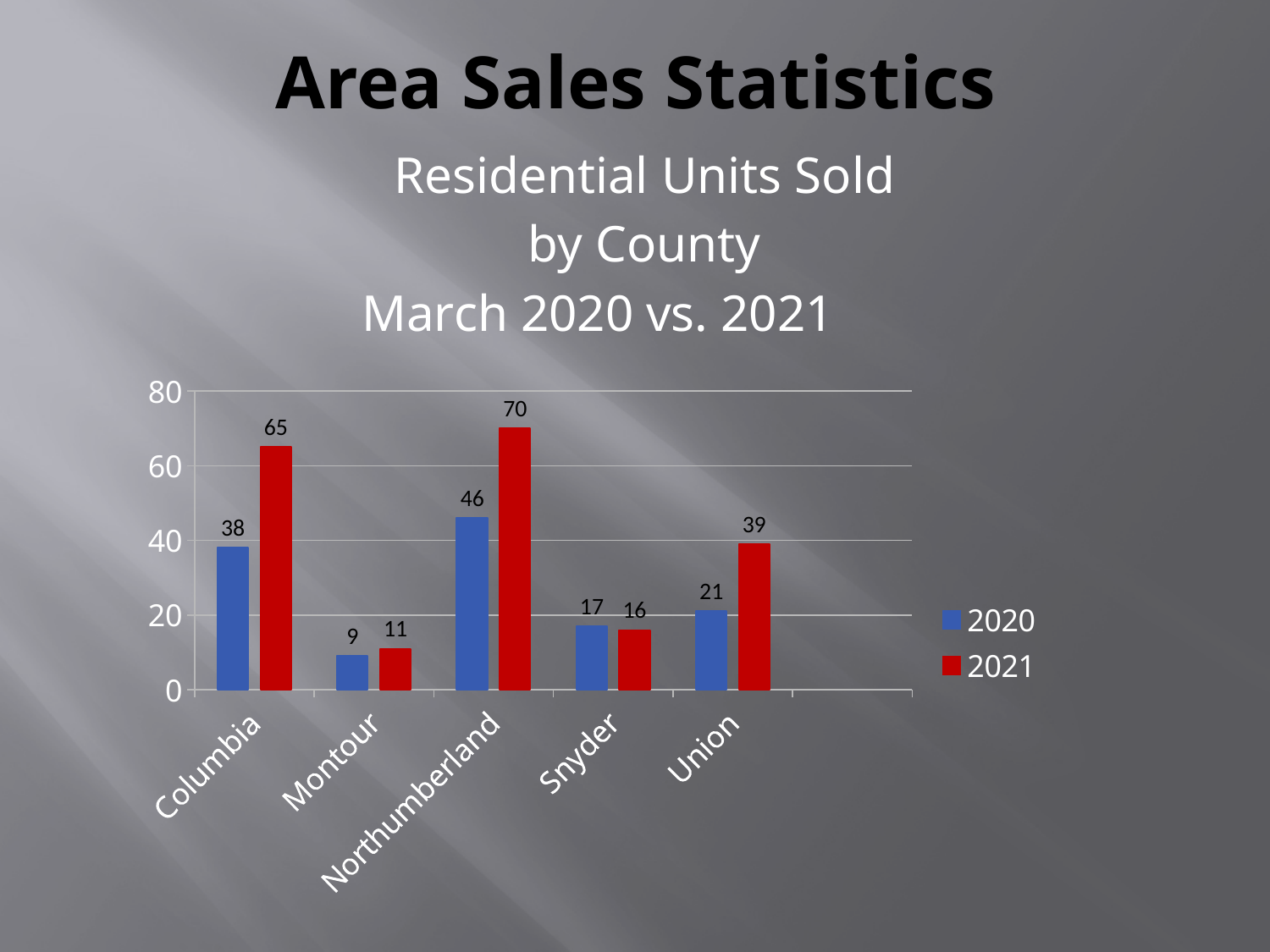
Which county has the highest value in 2021? Northumberland What is the value for Snyder in 2021? 16 Which is larger for Snyder, the 2020 value or the 2021 value? 2020 How many residential units were sold in Columbia in 2021? 65 What is the difference between the 2021 and 2020 values for Columbia? 27 How many counties are shown on the x axis? 5 Which colour represents 2021 in the chart? Red How many series does the legend list? 2 What is the difference between the 2021 and 2020 values for Union? 18 Which county has the lowest value in 2020? Montour What is the value for Northumberland in 2020? 46 What kind of chart is shown on the slide? Bar chart